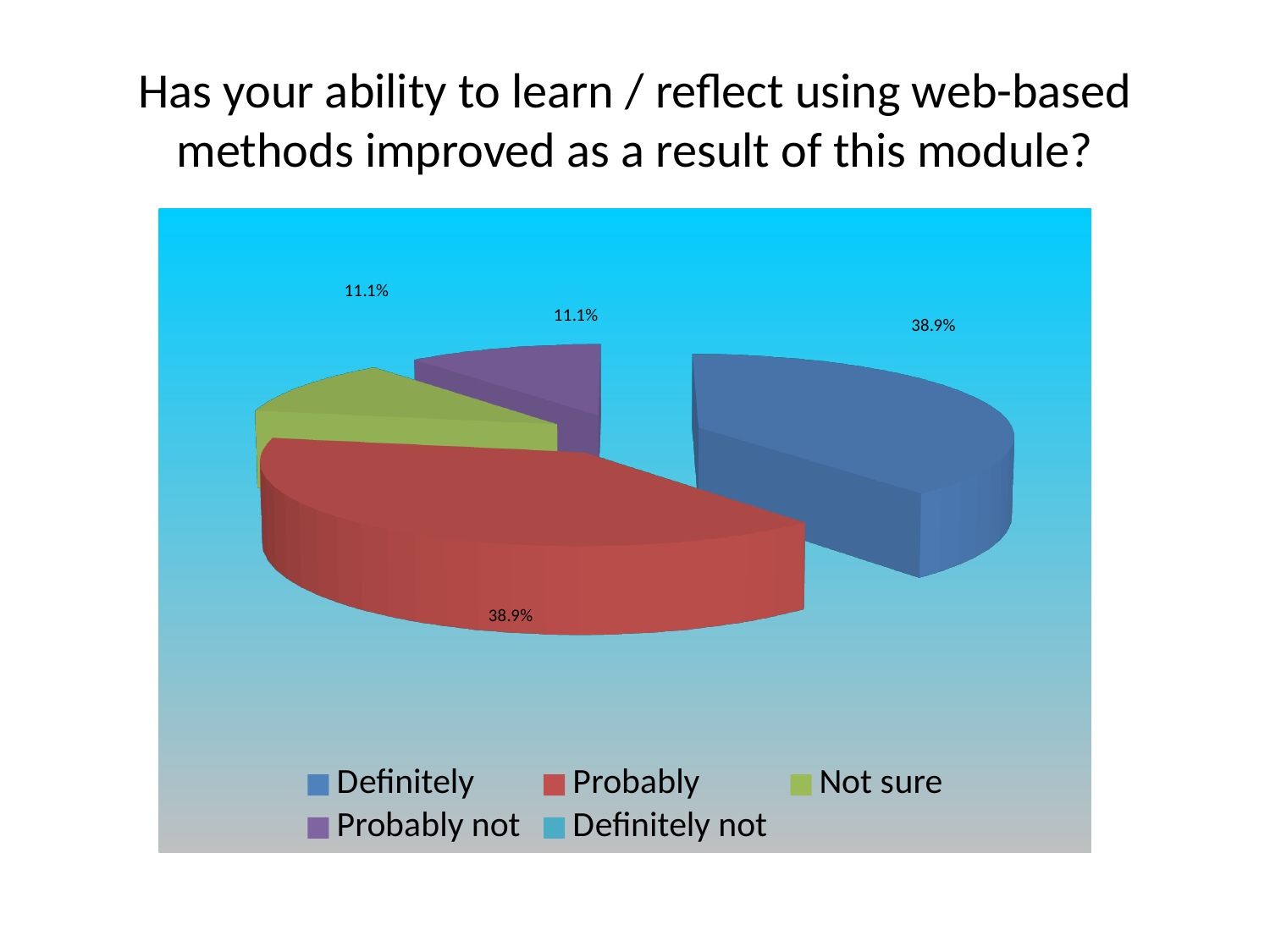
Which is larger, the share for "Probably" or the share for "Probably not"? Probably What is the combined share of "Definitely" and "Probably"? 77.8% How many entries does the legend list? 5 What percentage of respondents answered "Probably not"? 11.1% What percentage of respondents answered "Probably"? 38.9% What colour is the "Probably" slice? Red What percentage of respondents answered "Definitely"? 38.9% What percentage of respondents answered "Not sure"? 11.1% What is the difference in percentage points between the "Definitely" share and the "Not sure" share? 27.8 What kind of chart is shown on the slide? Pie chart What question is the chart's title asking? Has your ability to learn / reflect using web-based methods improved as a result of this module? Which is larger, the share for "Definitely" or the share for "Not sure"? Definitely